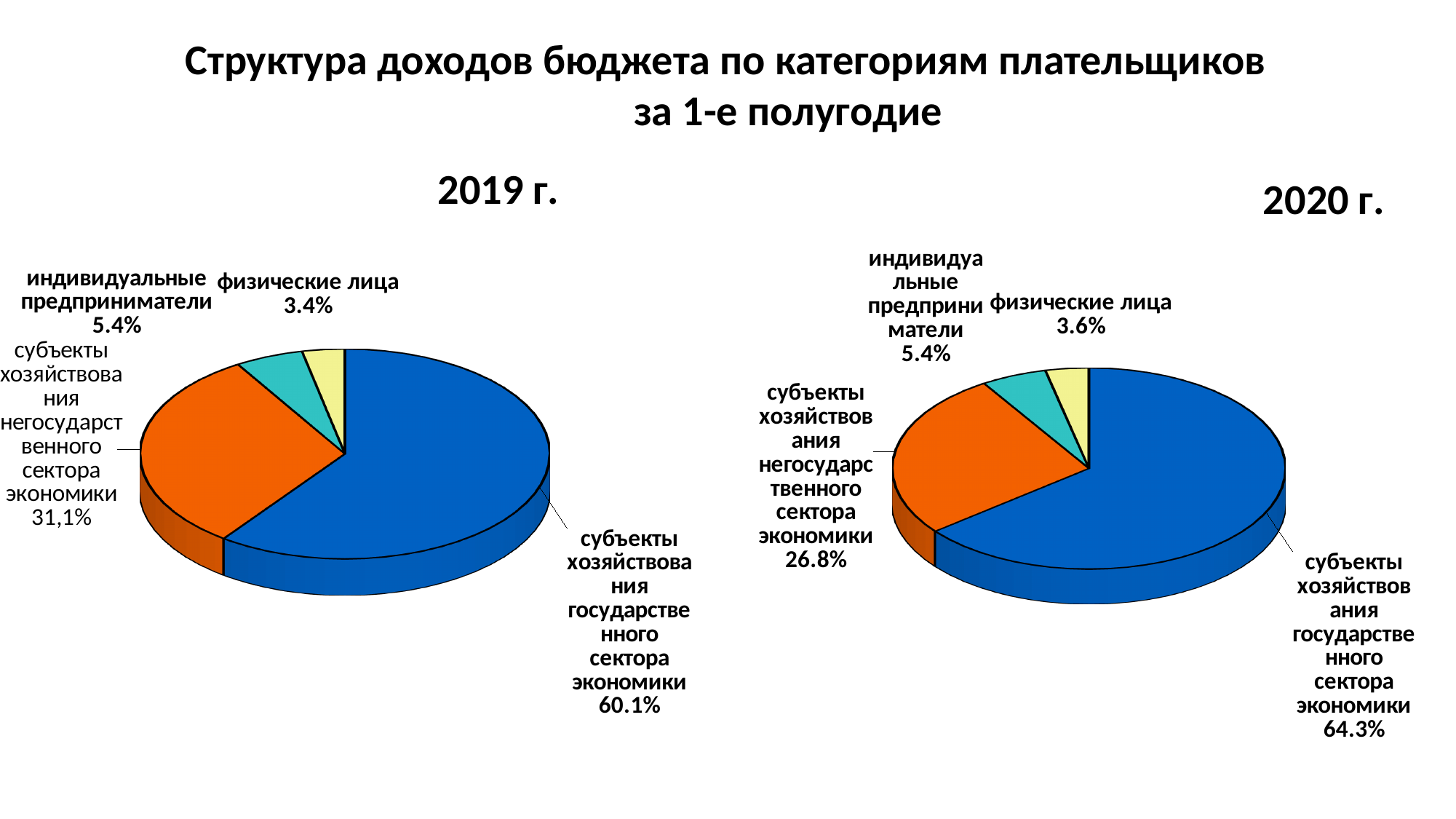
What type of chart is used for the 2019 г. and 2020 г. data? Pie chart In the 2020 г. pie chart, what share is shown for субъекты хозяйствования негосударственного сектора экономики? 26.8% In the 2020 г. pie chart, what is the difference between the shares of the государственный сектор and the негосударственный сектор? 37.5 percentage points By how many percentage points did the share of субъекты хозяйствования государственного сектора экономики change from the 2019 г. chart to the 2020 г. chart? 4.2 percentage points In the 2019 г. pie chart, which category has the smallest share? физические лица In the 2020 г. pie chart, what share is shown for индивидуальные предприниматели? 5.4% Which is larger: the share of физические лица in the 2019 г. chart or in the 2020 г. chart? 2020 г. In the 2019 г. pie chart, what share is shown for субъекты хозяйствования государственного сектора экономики? 60.1% In the 2019 г. pie chart, what share is shown for физические лица? 3.4% In the 2020 г. pie chart, which category has the largest share? субъекты хозяйствования государственного сектора экономики What is the title of the slide containing the two pie charts? Структура доходов бюджета по категориям плательщиков за 1-е полугодие How many categories does each pie chart on the slide show? 4